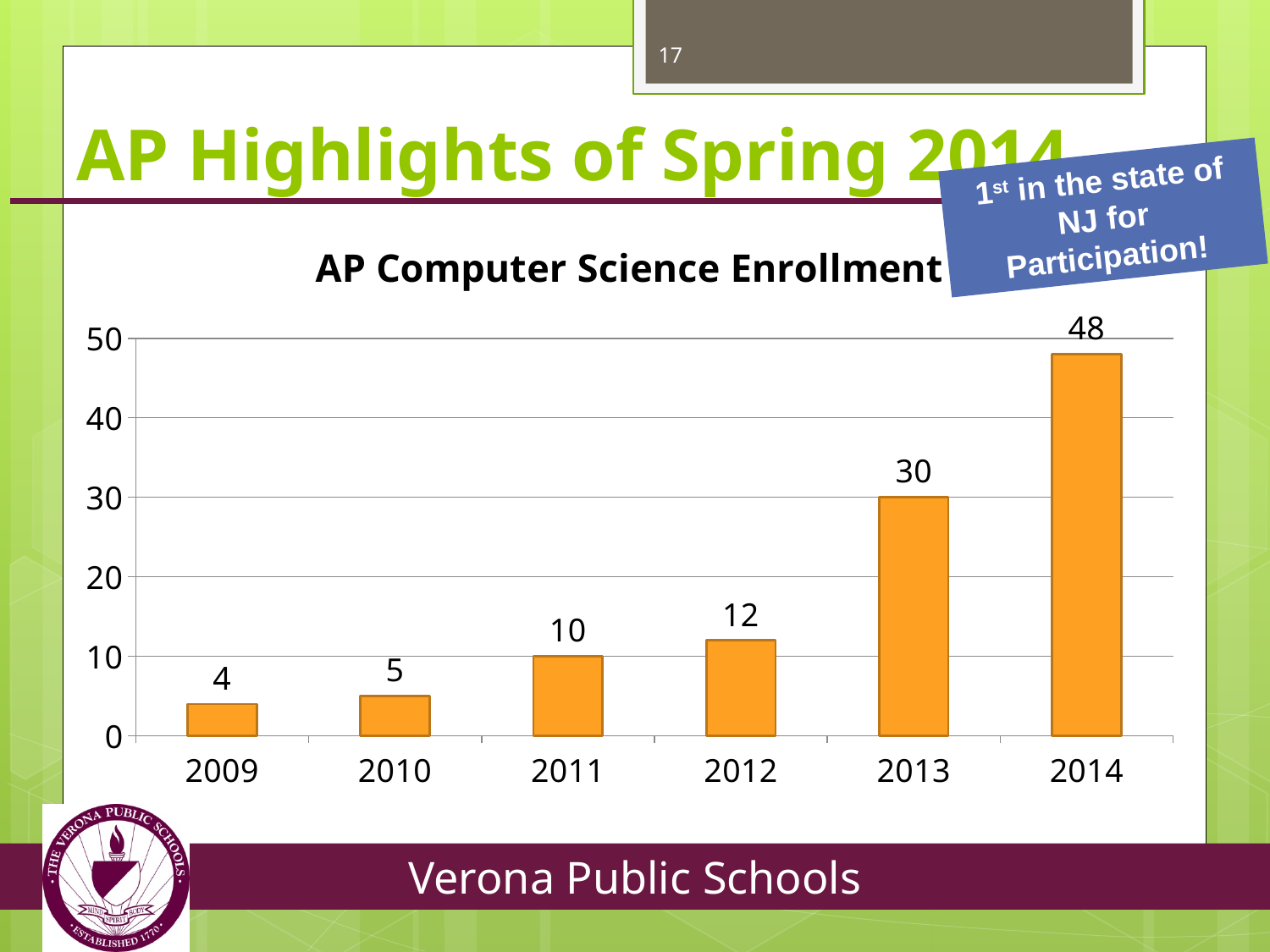
What kind of chart is shown on the slide? Bar chart Which year has the highest AP Computer Science enrollment? 2014 Does AP Computer Science enrollment rise or fall from 2009 to 2014? Rise What is the difference in enrollment between 2014 and 2013? 18 Is the enrollment for 2013 greater or less than 20? greater What is the AP Computer Science enrollment for 2011? 10 What is the difference in enrollment between 2012 and 2011? 2 How many years are shown on the chart? 6 What is the AP Computer Science enrollment for 2009? 4 What is the AP Computer Science enrollment for 2014? 48 Which year has higher enrollment, 2013 or 2012? 2013 Which year has the lowest AP Computer Science enrollment? 2009